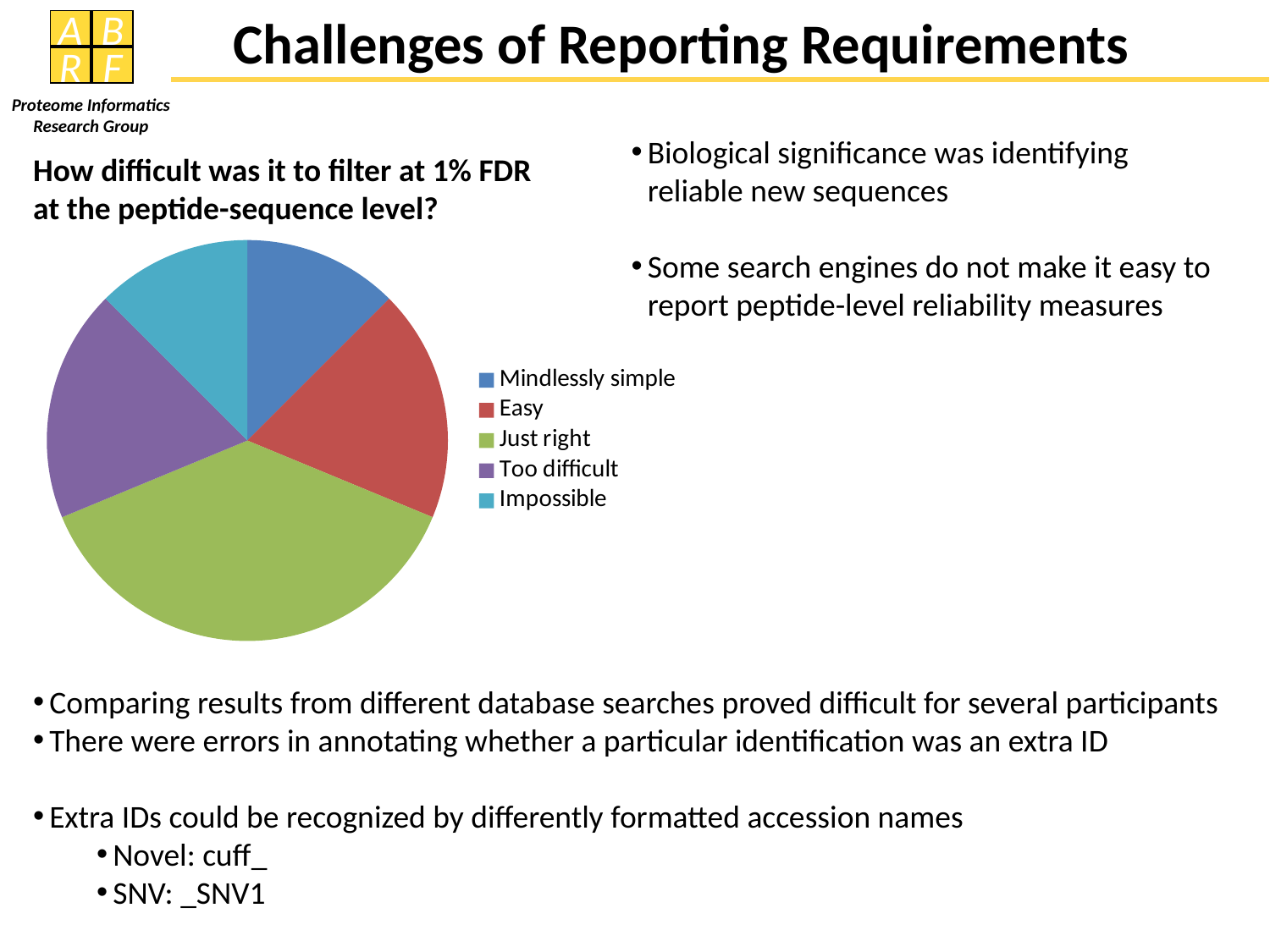
Which category has the largest slice in the pie chart? Just right Which slice is larger in the pie chart, Just right or Impossible? Just right Which slice is larger in the pie chart, Just right or Too difficult? Just right Which slice is larger in the pie chart, Just right or Easy? Just right What kind of chart is shown on the slide? pie chart Which category is shown in green in the pie chart? Just right What question does the pie chart answer, according to the text above it? How difficult was it to filter at 1% FDR at the peptide-sequence level? How many entries does the legend of the pie chart list? 5 How many slices does the pie chart have? 5